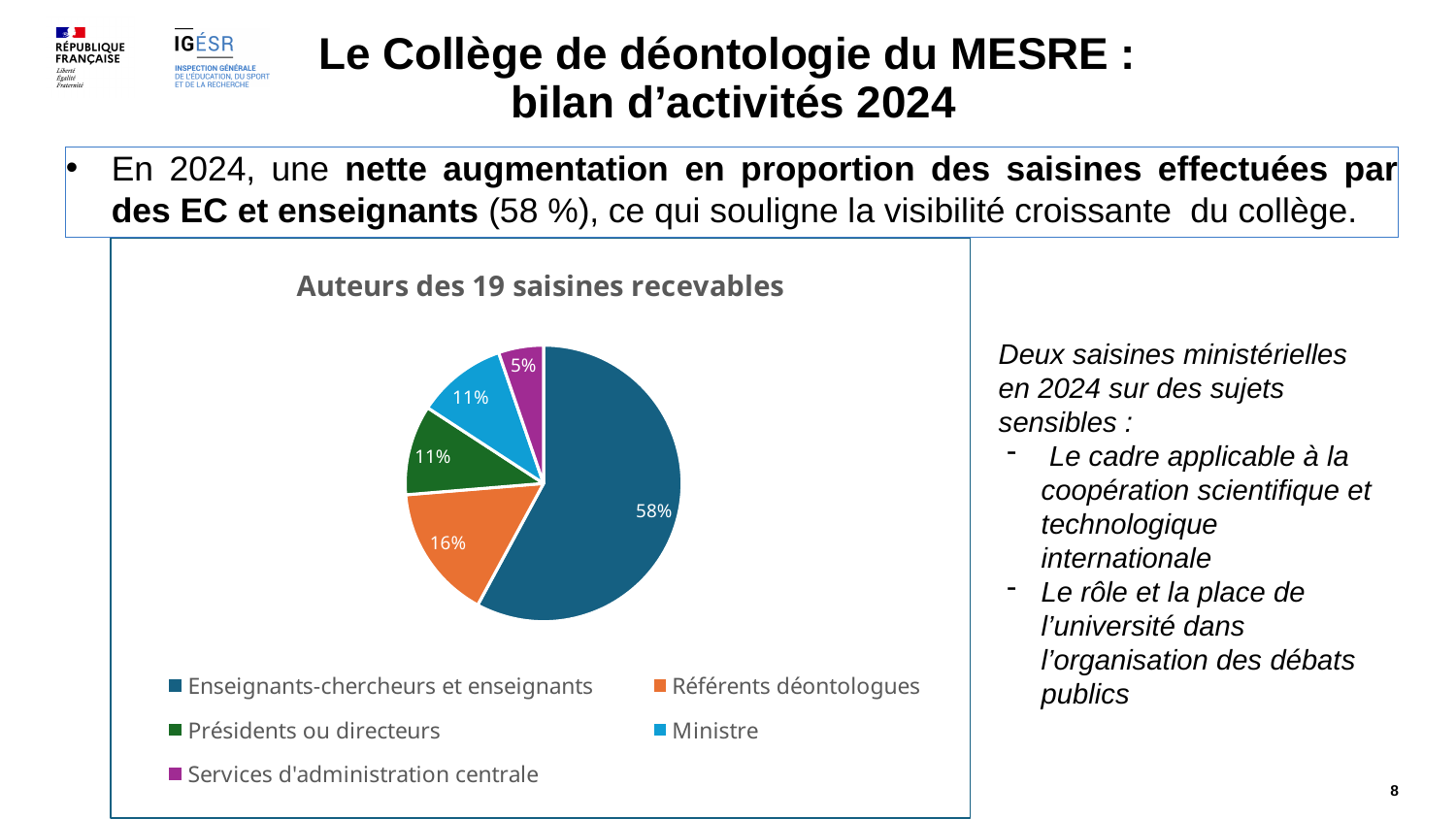
What colour is the slice for Services d'administration centrale? purple How many categories does the pie chart show? 5 What is the title of the chart? Auteurs des 19 saisines recevables Which slice is larger: Référents déontologues or Présidents ou directeurs? Référents déontologues Which category has the smallest slice of the pie? Services d'administration centrale Which category has the largest slice of the pie? Enseignants-chercheurs et enseignants What share of the pie is labelled for Services d'administration centrale? 5% What is the difference in percentage points between the Enseignants-chercheurs et enseignants slice and the Référents déontologues slice? 42 What share of the pie is labelled for Référents déontologues? 16% What share of the pie is labelled for Enseignants-chercheurs et enseignants? 58% What kind of chart is shown on the slide? pie chart